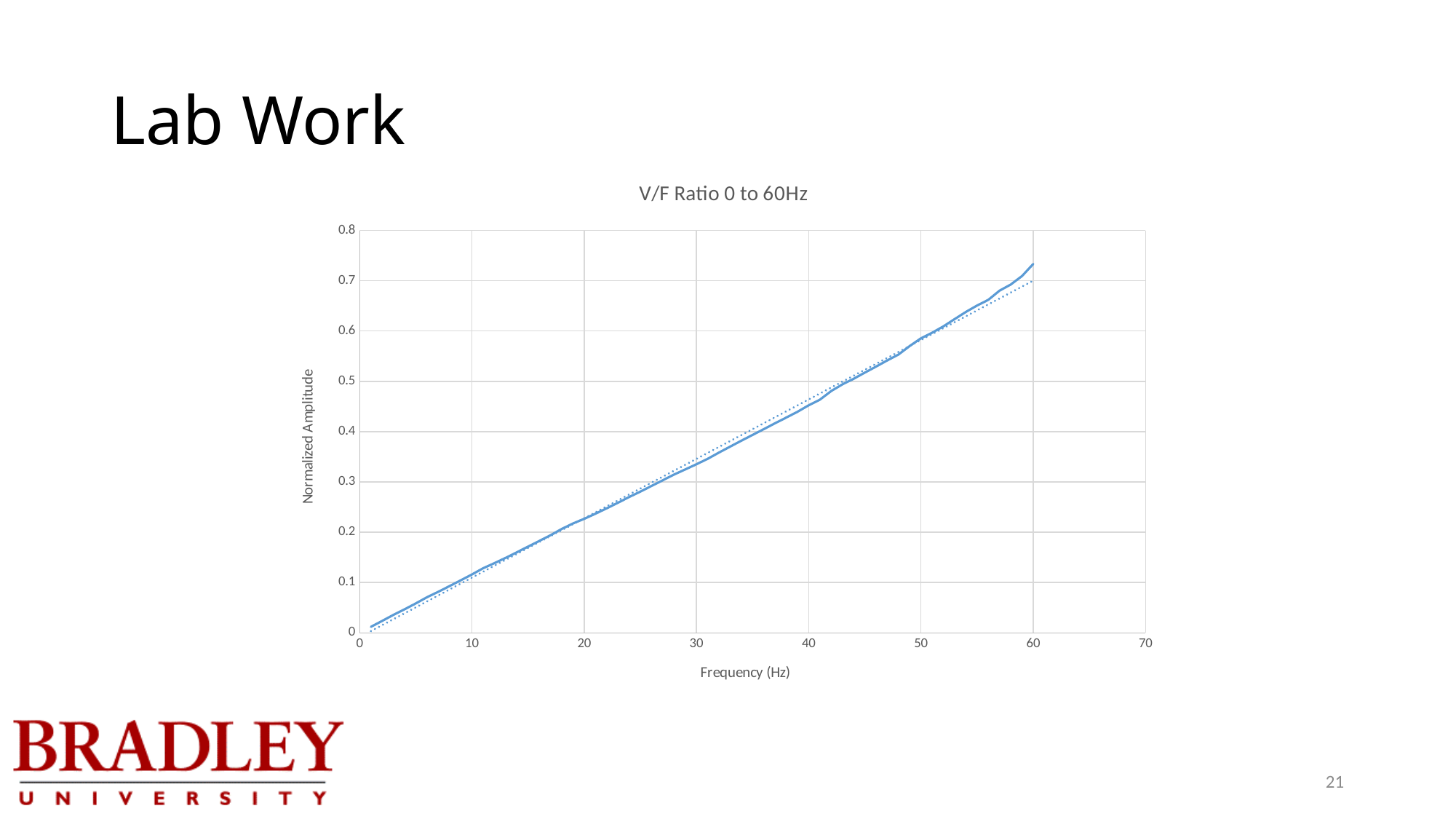
Is the normalized amplitude at 30 Hz greater or less than 0.4? less What is the title of the chart? V/F Ratio 0 to 60Hz Is the normalized amplitude higher at 60 Hz or at 10 Hz? 60 Hz What is the label of the vertical axis? Normalized Amplitude Is the normalized amplitude at 50 Hz greater or less than 0.6? less At which plotted frequency is the normalized amplitude highest? 60 Hz Is the normalized amplitude at 60 Hz greater or less than 0.7? greater Does the normalized amplitude rise or fall as frequency increases from 0 to 60 Hz? rise What kind of chart is shown on the slide? line chart